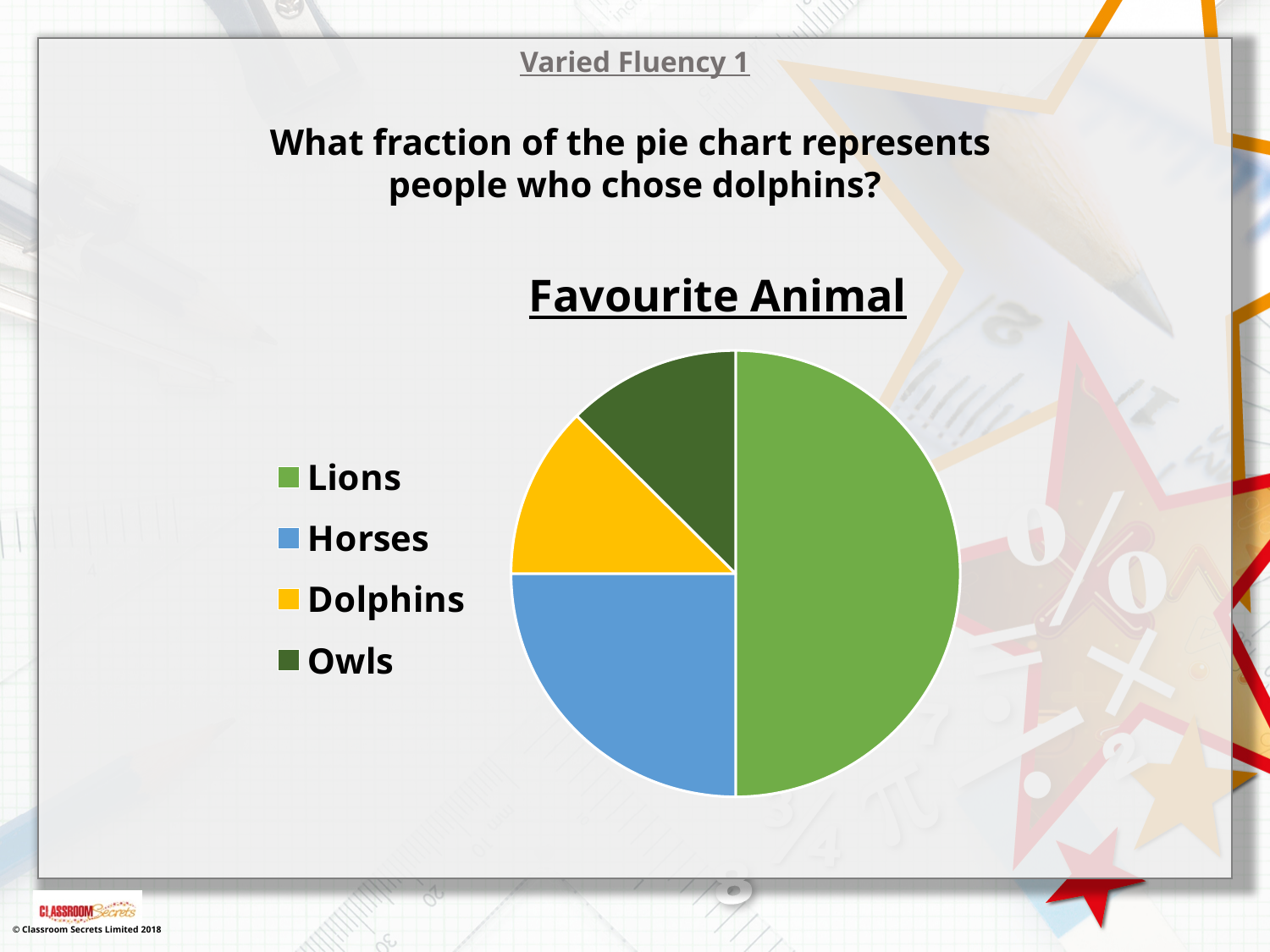
Which animal has the largest slice of the pie chart? Lions What is the title of the chart? Favourite Animal How many entries does the legend list? 4 How many categories does the pie chart have? 4 Which slice is larger, Lions or Owls? Lions Which slice is larger, Horses or Dolphins? Horses What colour is the Dolphins slice in the pie chart? yellow Which slice is larger, Lions or Horses? Lions What kind of chart is shown on the slide? pie chart